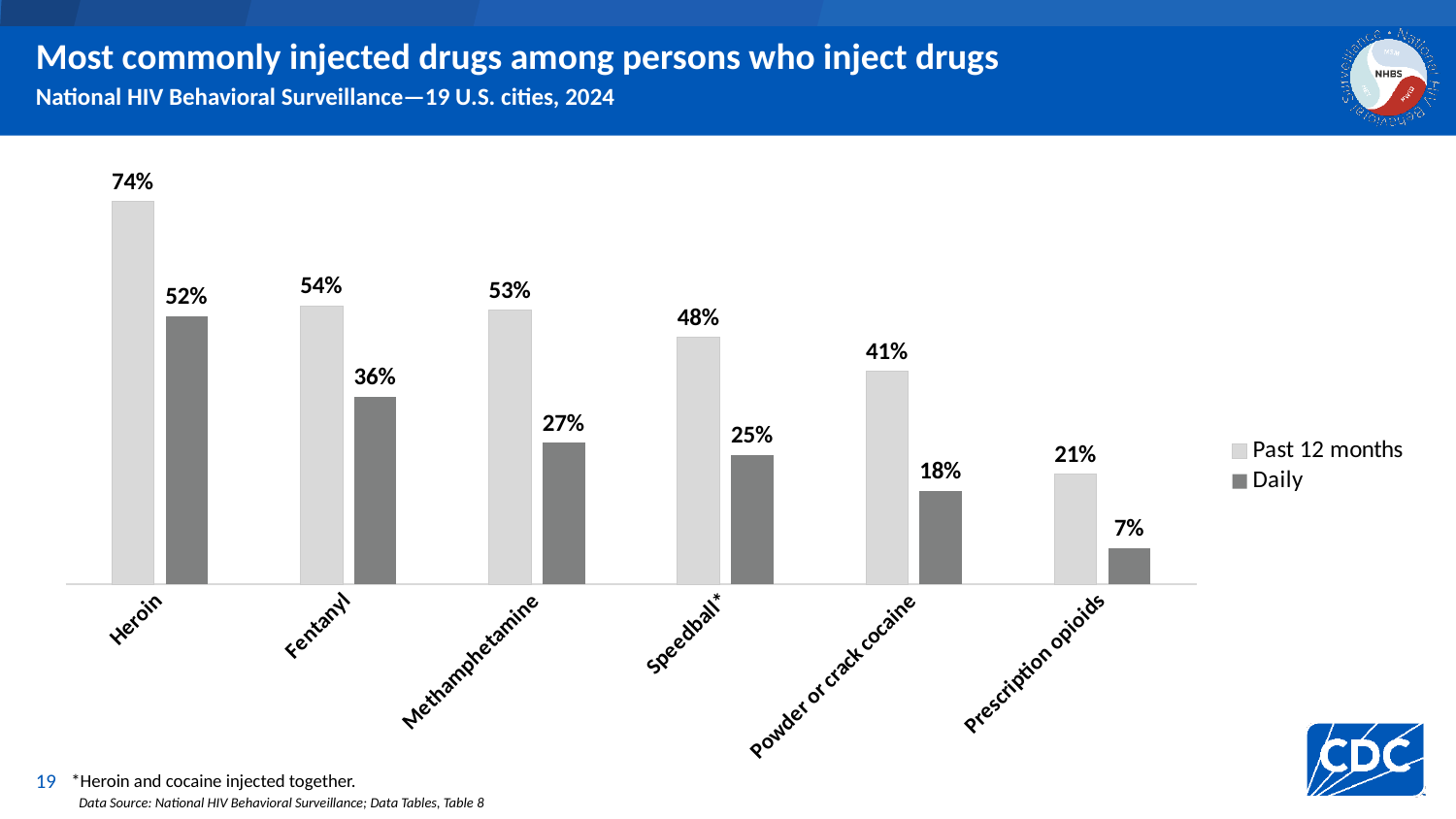
Which is larger: the Daily value for speedball or the Daily value for powder or crack cocaine? Speedball Do the Past 12 months values rise or fall from left to right across the categories? Fall Which drug has the highest Past 12 months value? Heroin What is the Past 12 months value for powder or crack cocaine? 41% How many drug categories are shown on the x axis? 6 What kind of chart is shown on the slide? Bar chart What are the two series named in the legend? Past 12 months and Daily What percentage of persons who inject drugs injected heroin in the past 12 months? 74% Which drug has the lowest Daily value? Prescription opioids How many series does the legend list? 2 What is the difference between the Past 12 months and Daily values for fentanyl? 18% What is the Daily value for methamphetamine? 27%